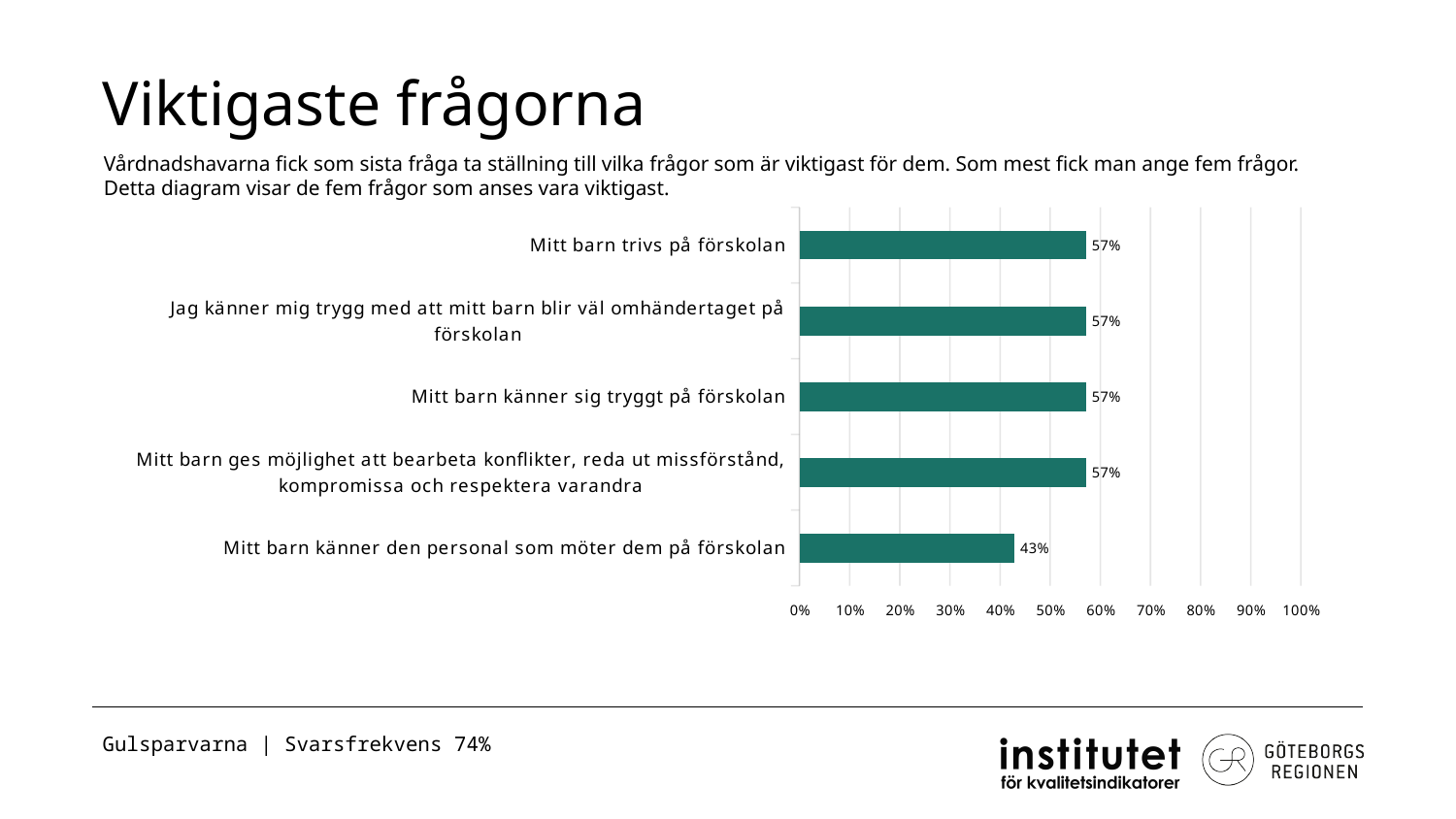
What is the title of the slide containing the chart? Viktigaste frågorna Is the value for "Mitt barn känner sig tryggt på förskolan" greater or less than 50%? greater Which category has the lowest value? Mitt barn känner den personal som möter dem på förskolan What is the value for "Mitt barn känner den personal som möter dem på förskolan"? 43% What kind of chart is shown on the slide? Bar chart What is the difference between the values for "Mitt barn känner sig tryggt på förskolan" and "Mitt barn känner den personal som möter dem på förskolan"? 14 percentage points Is the value for "Mitt barn känner den personal som möter dem på förskolan" greater or less than 50%? less What is the value for "Mitt barn ges möjlighet att bearbeta konflikter, reda ut missförstånd, kompromissa och respektera varandra"? 57% How many categories are shown in the chart? 5 What is the value for "Mitt barn trivs på förskolan"? 57% Which is larger: the value for "Mitt barn trivs på förskolan" or the value for "Mitt barn känner den personal som möter dem på förskolan"? Mitt barn trivs på förskolan What is the value for "Jag känner mig trygg med att mitt barn blir väl omhändertaget på förskolan"? 57%